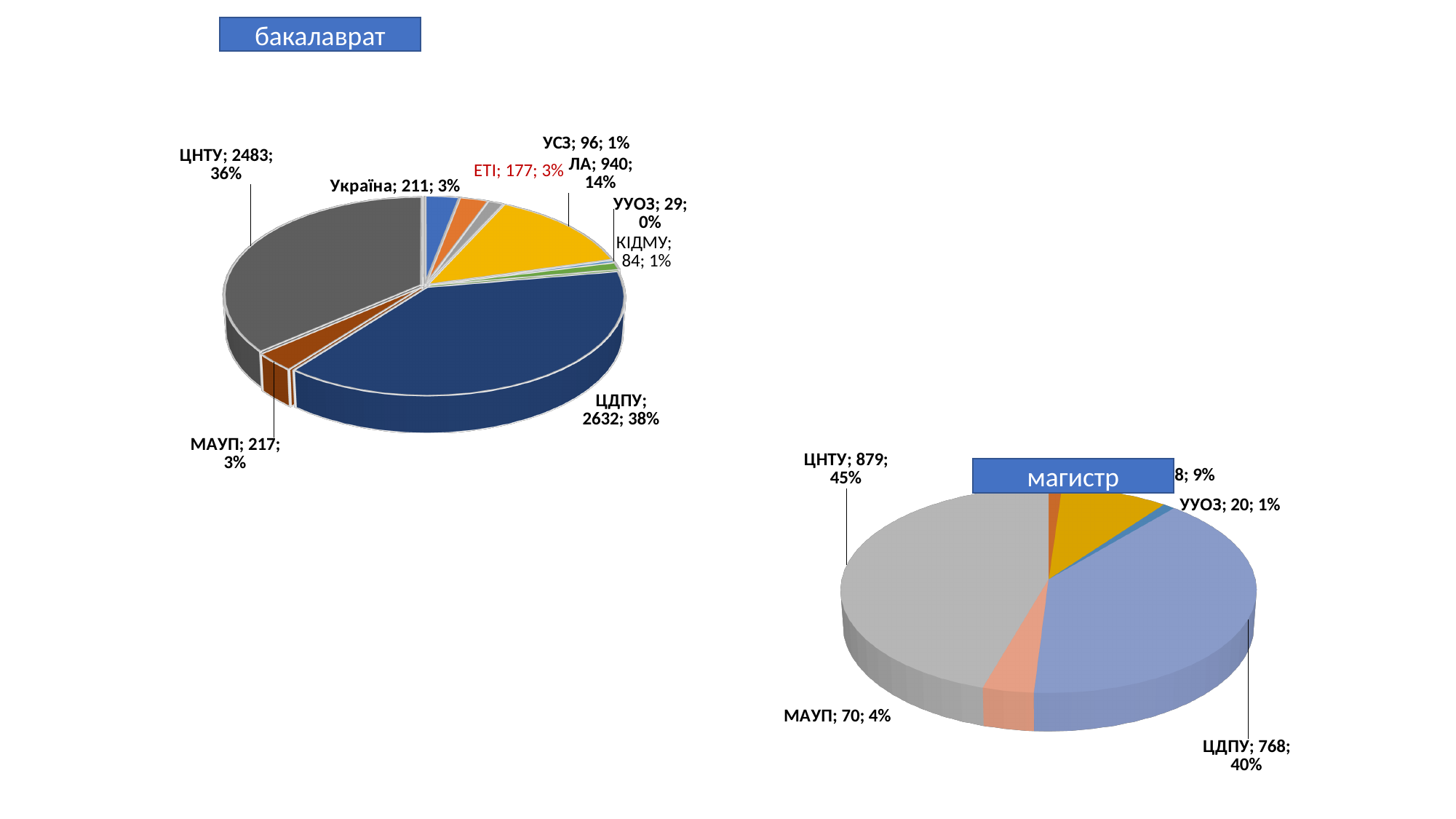
On the бакалаврат chart, what value is shown for ЦДПУ? 2632; 38% On the бакалаврат chart, what value is shown for ЛА? 940; 14% On the бакалаврат chart, which category has the largest slice? ЦДПУ On the магистр chart, which category has the largest slice? ЦНТУ What share of the бакалаврат pie does ЦНТУ represent? 36% What type of chart is used on this slide? Pie chart On the бакалаврат chart, what is the difference between the values for ЦДПУ and ЦНТУ? 149 On the магистр chart, what value is shown for ЦНТУ? 879; 45% On the бакалаврат chart, which is larger: МАУП or Україна? МАУП On the магистр chart, what is the difference between the values for ЦНТУ and ЦДПУ? 111 On the бакалаврат chart, which category has the smallest slice? УУОЗ How many slices does the бакалаврат pie chart have? 9